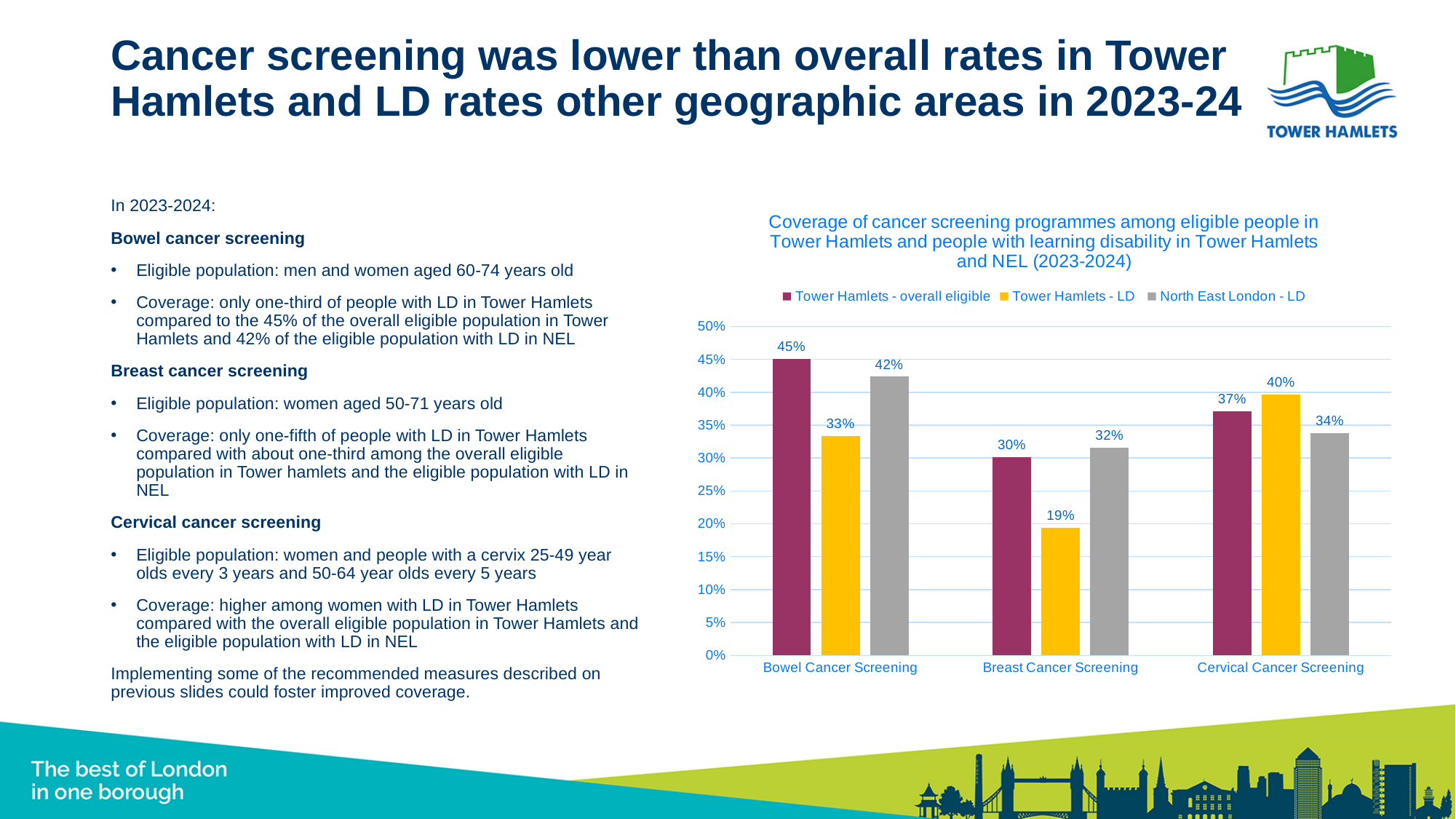
What is the value for Tower Hamlets - overall eligible in Cervical Cancer Screening? 37% In Cervical Cancer Screening, which is larger: Tower Hamlets - LD or North East London - LD? Tower Hamlets - LD How many screening programme categories are shown on the x axis? 3 What kind of chart is shown on the slide? Bar chart Which screening programme has the lowest value for Tower Hamlets - LD? Breast Cancer Screening What is the value for North East London - LD in Breast Cancer Screening? 32% How many series does the legend list? 3 What is the difference between North East London - LD and Tower Hamlets - LD in Breast Cancer Screening? 13% What is the value for Tower Hamlets - LD in Bowel Cancer Screening? 33% Which screening programme has the highest value for Tower Hamlets - overall eligible? Bowel Cancer Screening What is the difference between Tower Hamlets - overall eligible and Tower Hamlets - LD in Bowel Cancer Screening? 12% Is the value for Tower Hamlets - LD in Breast Cancer Screening greater or less than 20%? less